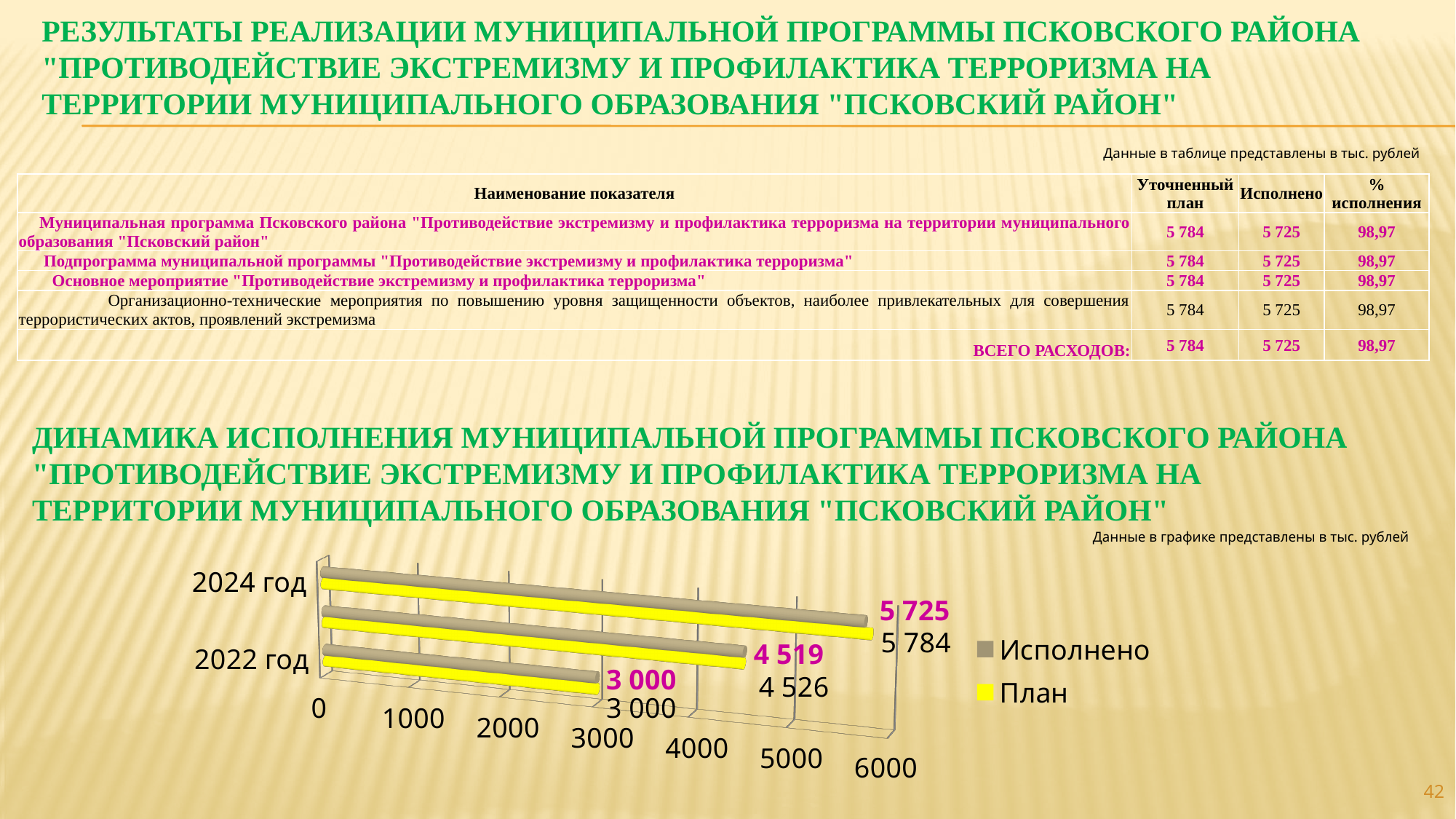
For 2024 год, which is larger: План or Исполнено? План What is the difference between План and Исполнено for 2024 год? 59 How many year categories are plotted in the chart? 3 Is the Исполнено value for 2024 год greater or less than 5000? greater How many series does the legend list? 2 What is the value of Исполнено for 2024 год? 5 725 What is the value of Исполнено for 2022 год? 3 000 Which year has the lowest План value? 2022 год What kind of chart is shown on the slide? Bar chart Which year has the highest Исполнено value? 2024 год What is the value of План for 2024 год? 5 784 Do the Исполнено values rise or fall from 2022 год to 2024 год? Rise